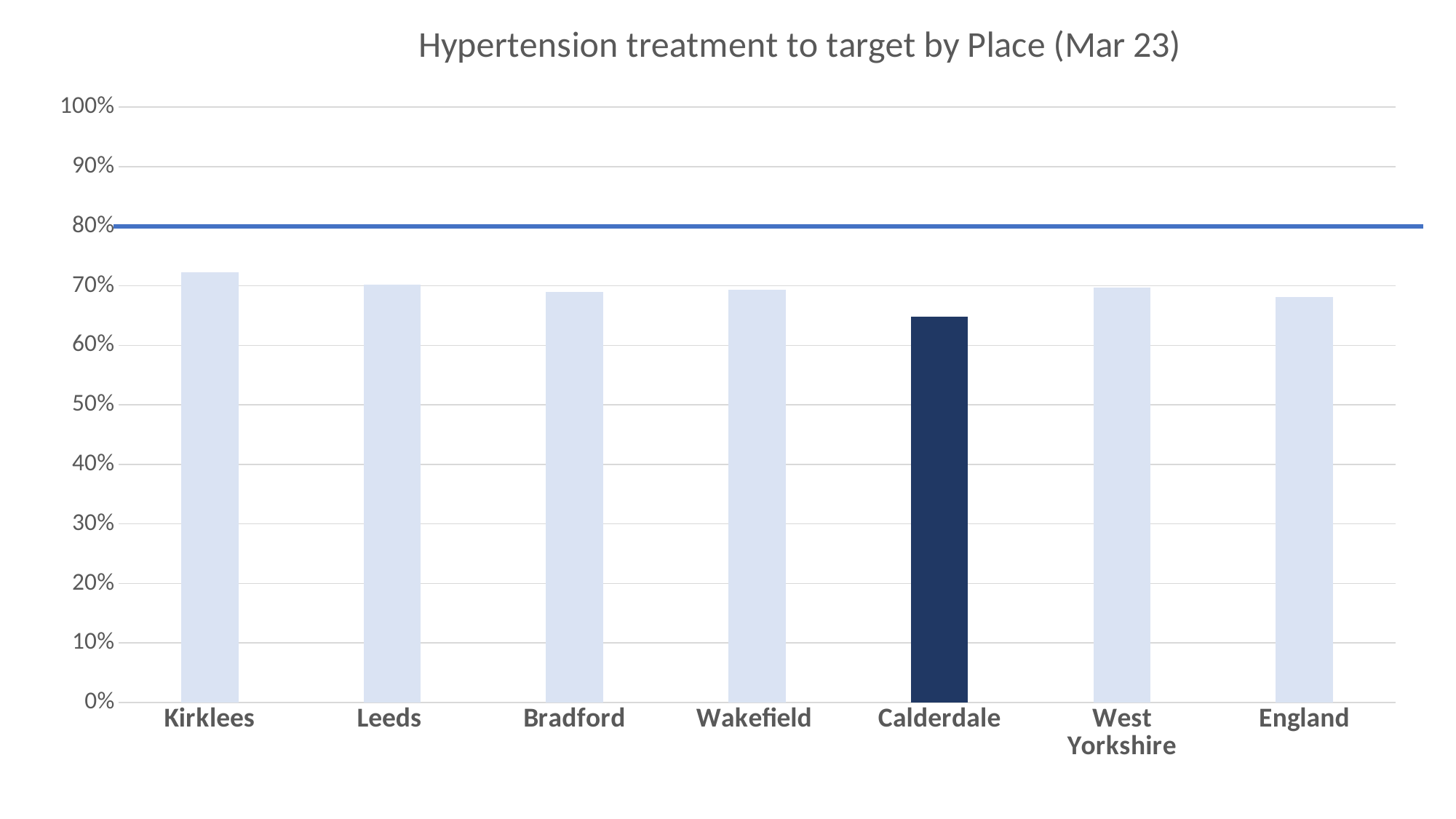
What is the title of the chart? Hypertension treatment to target by Place (Mar 23) Which place has the lowest hypertension treatment to target value? Calderdale How many places (categories) are plotted on the x axis? 7 Which is larger, the value for Kirklees or the value for Calderdale? Kirklees What type of chart is shown on the slide? Bar chart Is the value for Leeds greater or less than 80%? less Is the value for Calderdale greater or less than 70%? less Is the value for Calderdale greater or less than 60%? greater Which place's bar is shaded in dark navy rather than light blue? Calderdale Which place has the highest hypertension treatment to target value? Kirklees Which is larger, the value for England or the value for Calderdale? England